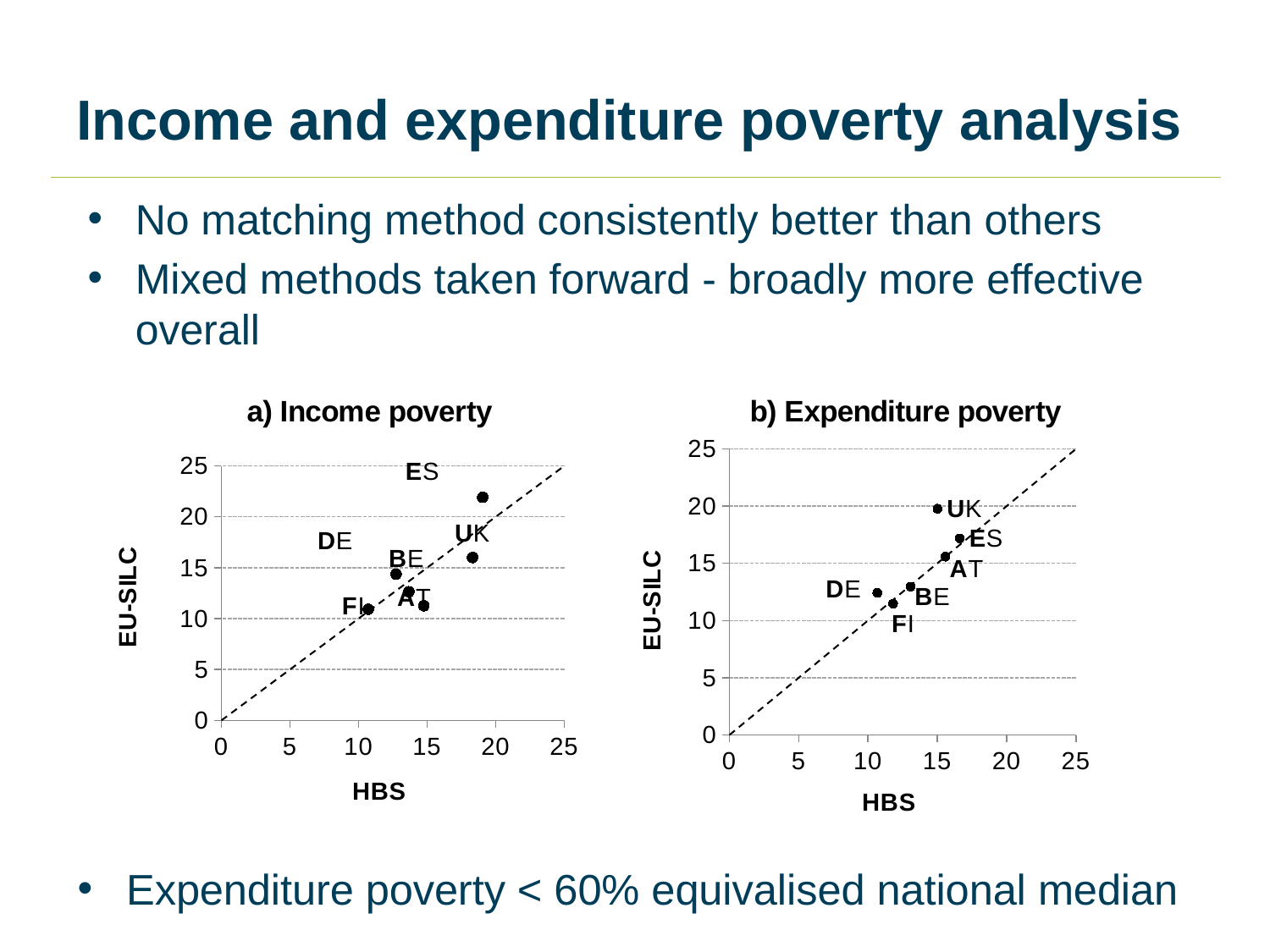
In the 'a) Income poverty' chart, is the EU-SILC value for ES greater or less than 20? greater In the 'a) Income poverty' chart, which has the higher EU-SILC value, ES or UK? ES In the 'b) Expenditure poverty' chart, which country has the highest EU-SILC value? UK In the 'a) Income poverty' chart, which country has the highest EU-SILC value? ES What kind of chart is 'b) Expenditure poverty'? scatter chart In the 'b) Expenditure poverty' chart, which country has the lowest EU-SILC value? FI In the 'a) Income poverty' chart, is the HBS value for UK greater or less than 15? greater What is the label on the vertical axis of the 'b) Expenditure poverty' chart? EU-SILC In the 'b) Expenditure poverty' chart, is the HBS value for ES greater or less than 15? greater In the 'b) Expenditure poverty' chart, how many data points are plotted? 6 What kind of chart is 'a) Income poverty'? scatter chart